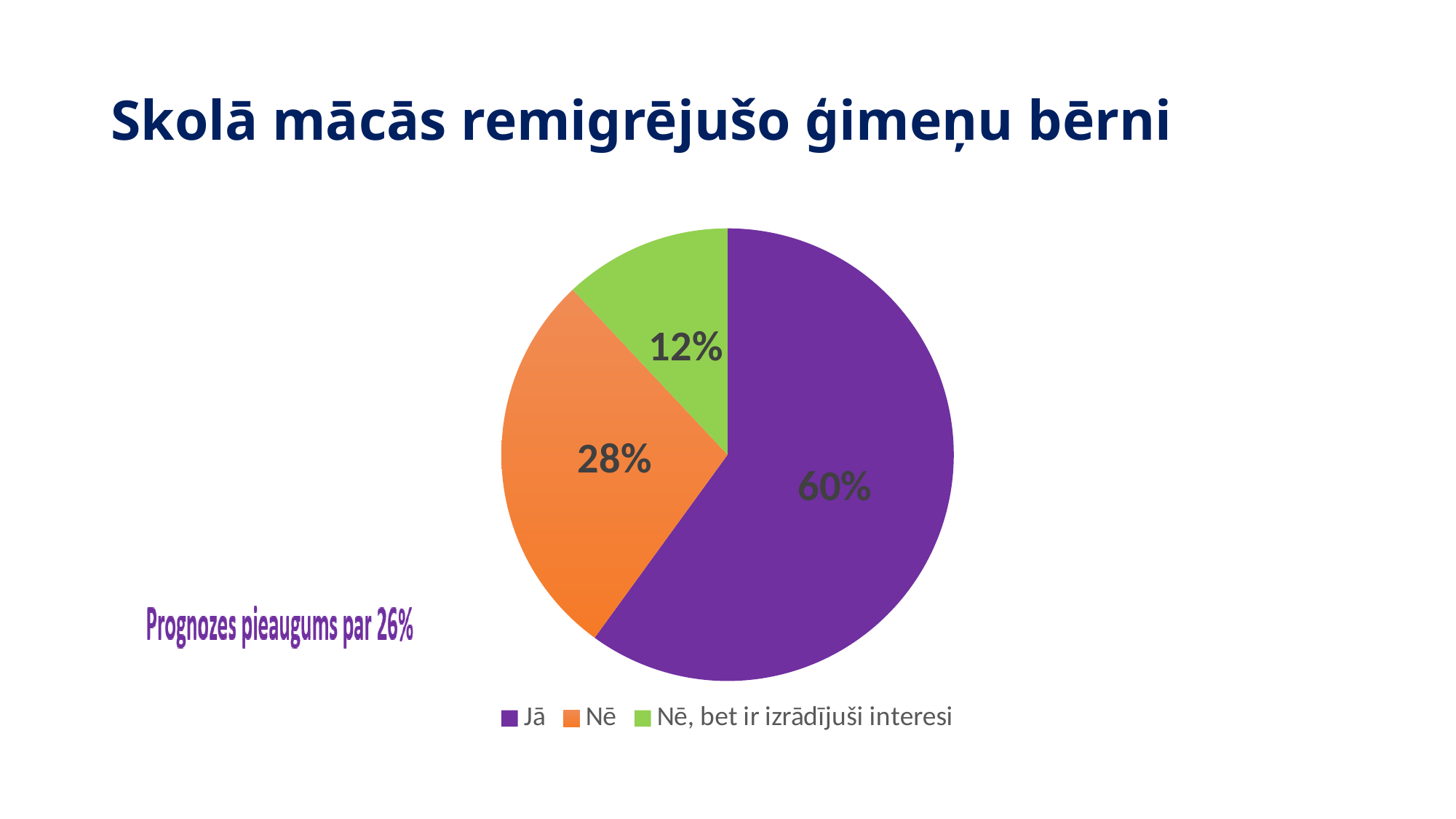
Which category has the largest share of the pie? Jā What percentage of the pie is labelled "Jā"? 60% What percentage of the pie is labelled "Nē, bet ir izrādījuši interesi"? 12% What is the difference in percentage points between the "Jā" and "Nē" slices? 32 How many slices does the pie chart have? 3 What colour is the "Jā" slice? purple Which slice is larger, "Nē" or "Nē, bet ir izrādījuši interesi"? Nē What is the difference in percentage points between the "Nē" slice and the "Nē, bet ir izrādījuši interesi" slice? 16 What is the title of the slide? Skolā mācās remigrējušo ģimeņu bērni Which category has the smallest share of the pie? Nē, bet ir izrādījuši interesi What type of chart is shown on the slide? pie chart What percentage of the pie is labelled "Nē"? 28%